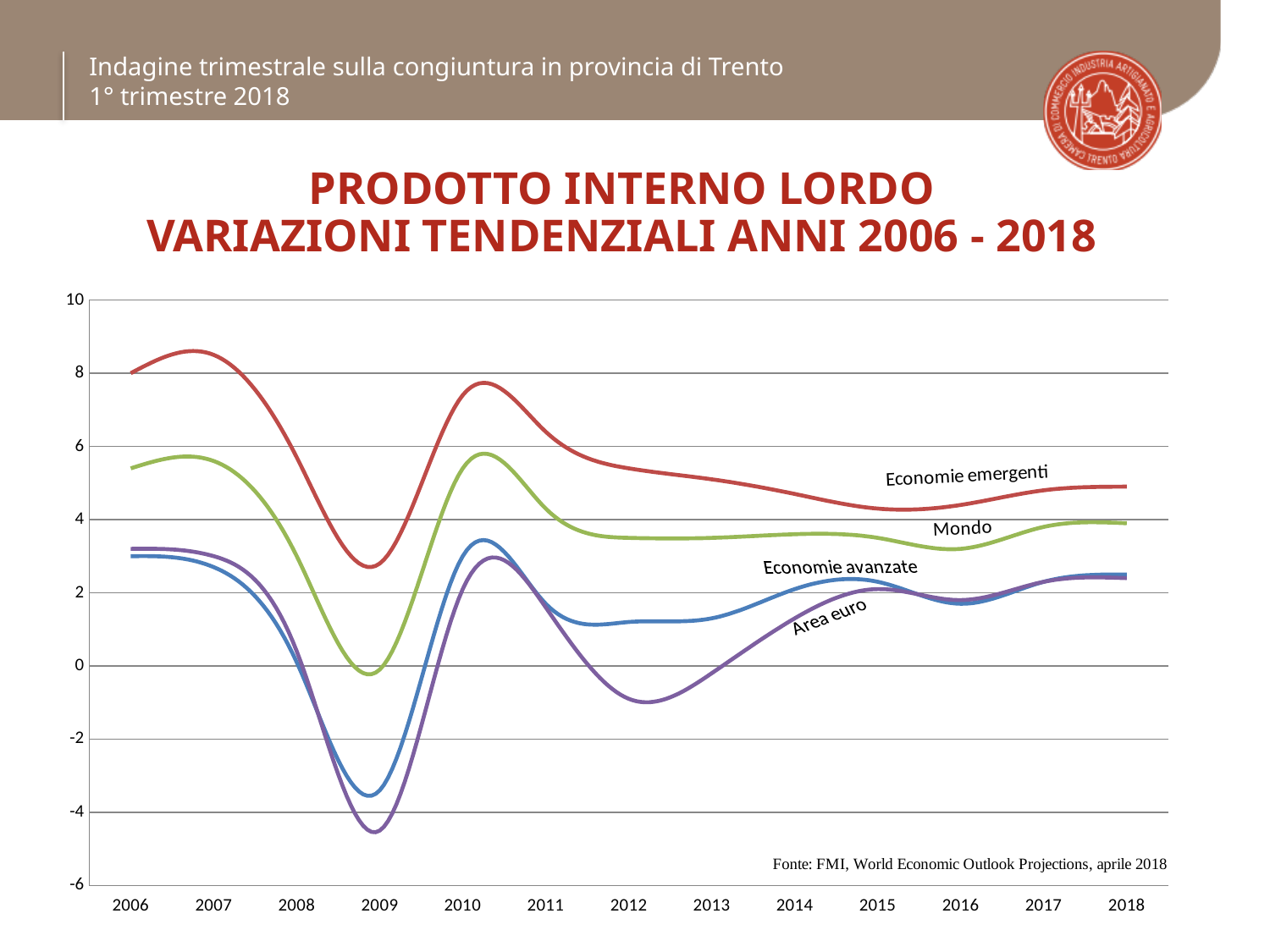
Is the value for Economie emergenti in 2006 greater or less than 6? greater In 2012, which is larger: Economie avanzate or Area euro? Economie avanzate Is the value for Economie avanzate in 2018 greater or less than 2? greater Is the value for Mondo in 2009 greater or less than 2? less Which series has the highest value in 2006? Economie emergenti Which series has the lowest value in 2009? Area euro Does the Economie emergenti line rise or fall between 2010 and 2015? fall What is the title of the chart? PRODOTTO INTERNO LORDO VARIAZIONI TENDENZIALI ANNI 2006 - 2018 How many series are plotted on the chart? 4 What kind of chart is shown on the slide? line chart How many years are labelled on the x axis of the chart? 13